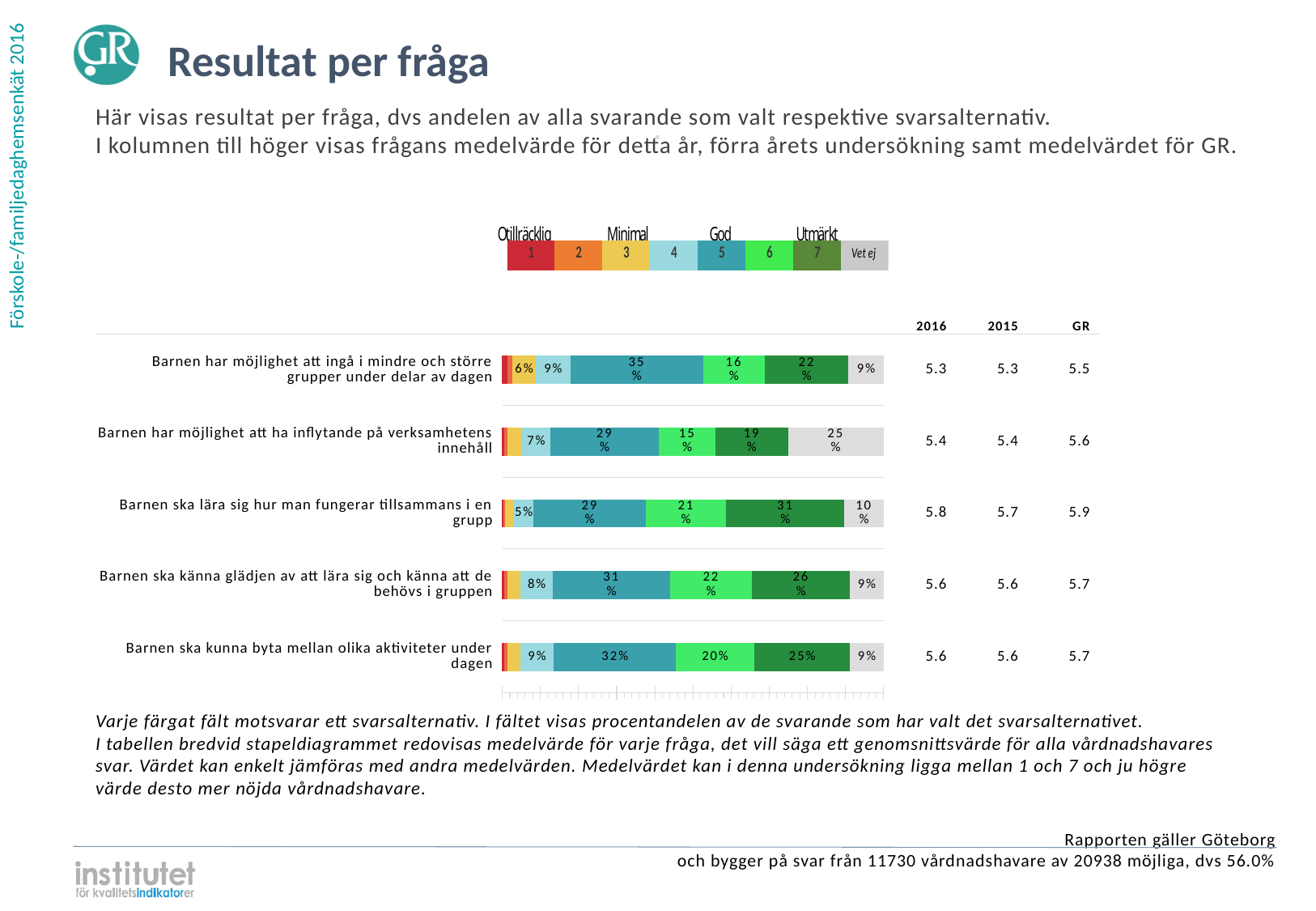
How many questions (categories) are plotted in the bar chart? 5 Which is larger for "Barnen ska känna glädjen av att lära sig och känna att de behövs i gruppen": the share for option 5 or the share for option 7? Option 5 What is the difference between the option 7 share and the option 6 share for "Barnen ska kunna byta mellan olika aktiviteter under dagen"? 5% What percentage chose "Vet ej" for "Barnen har möjlighet att ha inflytande på verksamhetens innehåll"? 25% What percentage of respondents chose option 5 for "Barnen har möjlighet att ingå i mindre och större grupper under delar av dagen"? 35% What kind of chart is shown on the slide? Stacked bar chart What percentage chose option 7 for "Barnen ska lära sig hur man fungerar tillsammans i en grupp"? 31% Which question has the highest share of respondents choosing option 7? Barnen ska lära sig hur man fungerar tillsammans i en grupp How many response options does the legend above the chart list? 8 Which question has the highest share of "Vet ej" answers? Barnen har möjlighet att ha inflytande på verksamhetens innehåll What is the GR mean value for "Barnen har möjlighet att ingå i mindre och större grupper under delar av dagen"? 5.5 What is the 2016 mean value for "Barnen ska lära sig hur man fungerar tillsammans i en grupp"? 5.8